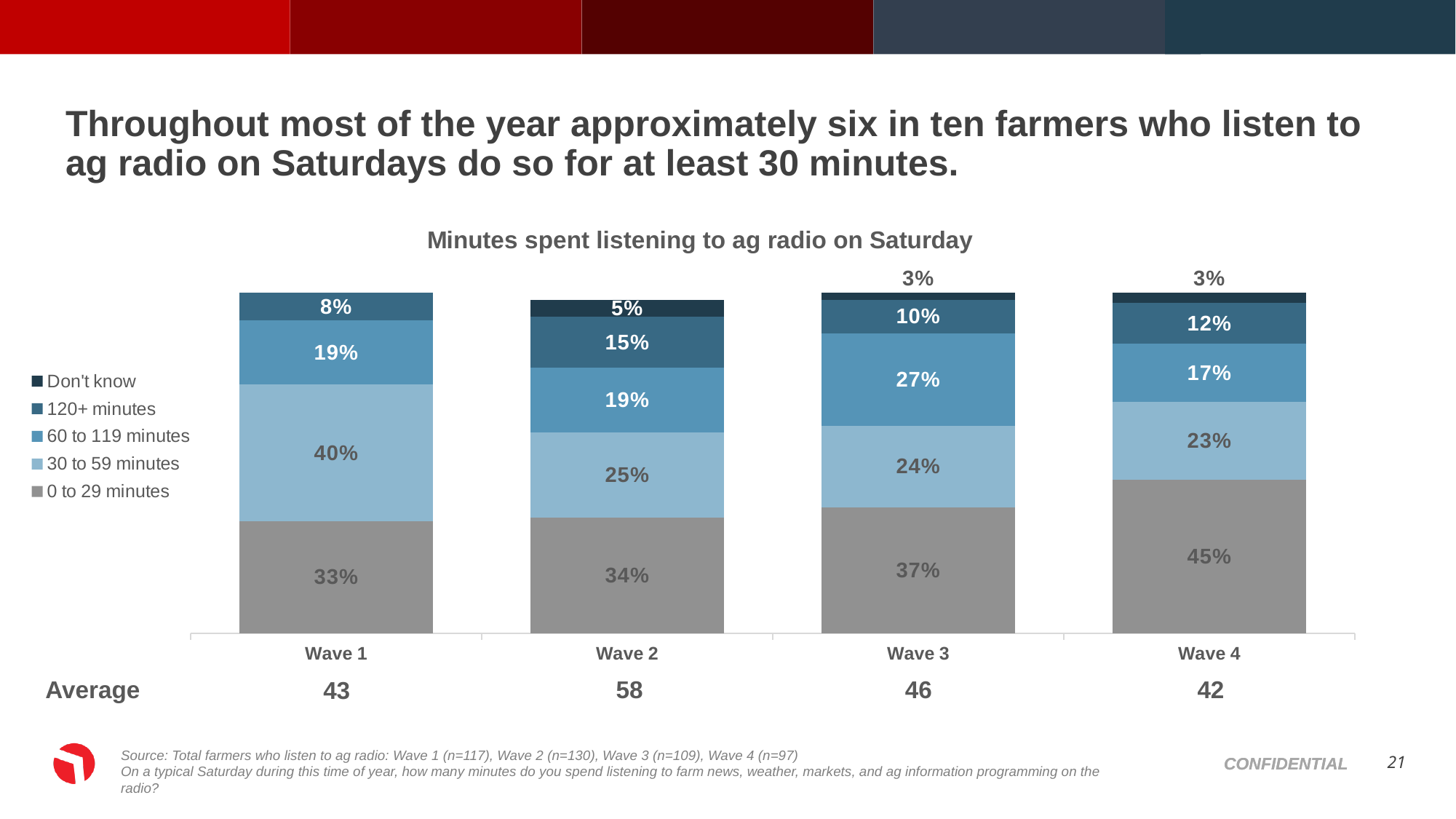
Does the 0 to 29 minutes share rise or fall from Wave 1 to Wave 4? Rises What is the value for 60 to 119 minutes in Wave 3? 27% Which wave has the lowest share for 120+ minutes? Wave 1 How much larger is the 0 to 29 minutes share in Wave 4 than in Wave 1? 12 percentage points How many series does the legend list? 5 Which is larger, the 120+ minutes share in Wave 2 or in Wave 4? Wave 2 What kind of chart is shown on the slide? Stacked bar chart What is the Don't know value for Wave 2? 5% How many waves are shown on the x axis? 4 What is the title of the chart? Minutes spent listening to ag radio on Saturday What percentage of Wave 1 listeners spent 30 to 59 minutes listening? 40% Which wave has the highest share for 0 to 29 minutes? Wave 4